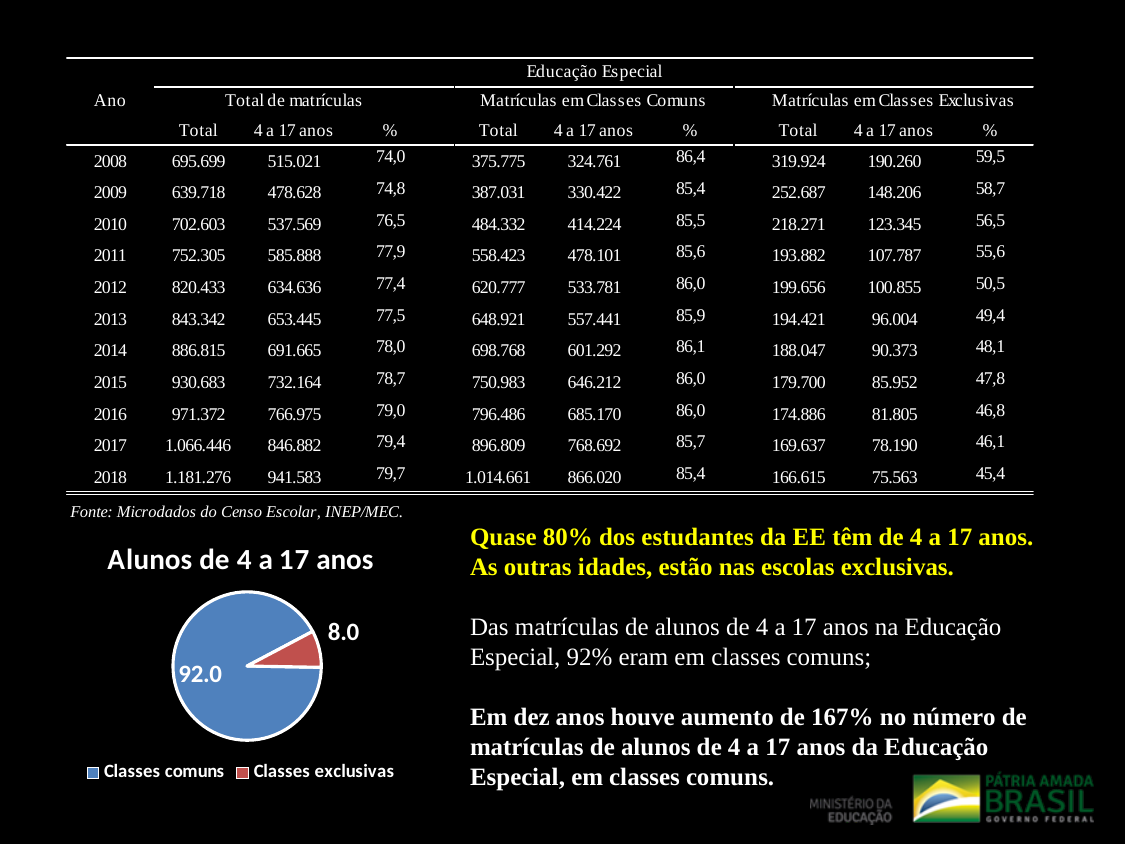
In the pie chart "Alunos de 4 a 17 anos", what is the difference between the Classes comuns and Classes exclusivas values? 84.0 In the pie chart "Alunos de 4 a 17 anos", which category has the largest slice? Classes comuns In the pie chart "Alunos de 4 a 17 anos", what share of the pie does Classes comuns represent? 92.0 In the pie chart "Alunos de 4 a 17 anos", what is the value for Classes comuns? 92.0 In the pie chart "Alunos de 4 a 17 anos", what colour is the Classes exclusivas slice? red What is the title of the pie chart on the slide? Alunos de 4 a 17 anos What kind of chart is shown under the title "Alunos de 4 a 17 anos"? pie chart How many entries does the legend of the pie chart "Alunos de 4 a 17 anos" list? 2 In the pie chart "Alunos de 4 a 17 anos", what is the value for Classes exclusivas? 8.0 In the pie chart "Alunos de 4 a 17 anos", which is larger: Classes comuns or Classes exclusivas? Classes comuns In the pie chart "Alunos de 4 a 17 anos", which category has the smallest slice? Classes exclusivas How many slices does the pie chart "Alunos de 4 a 17 anos" have? 2